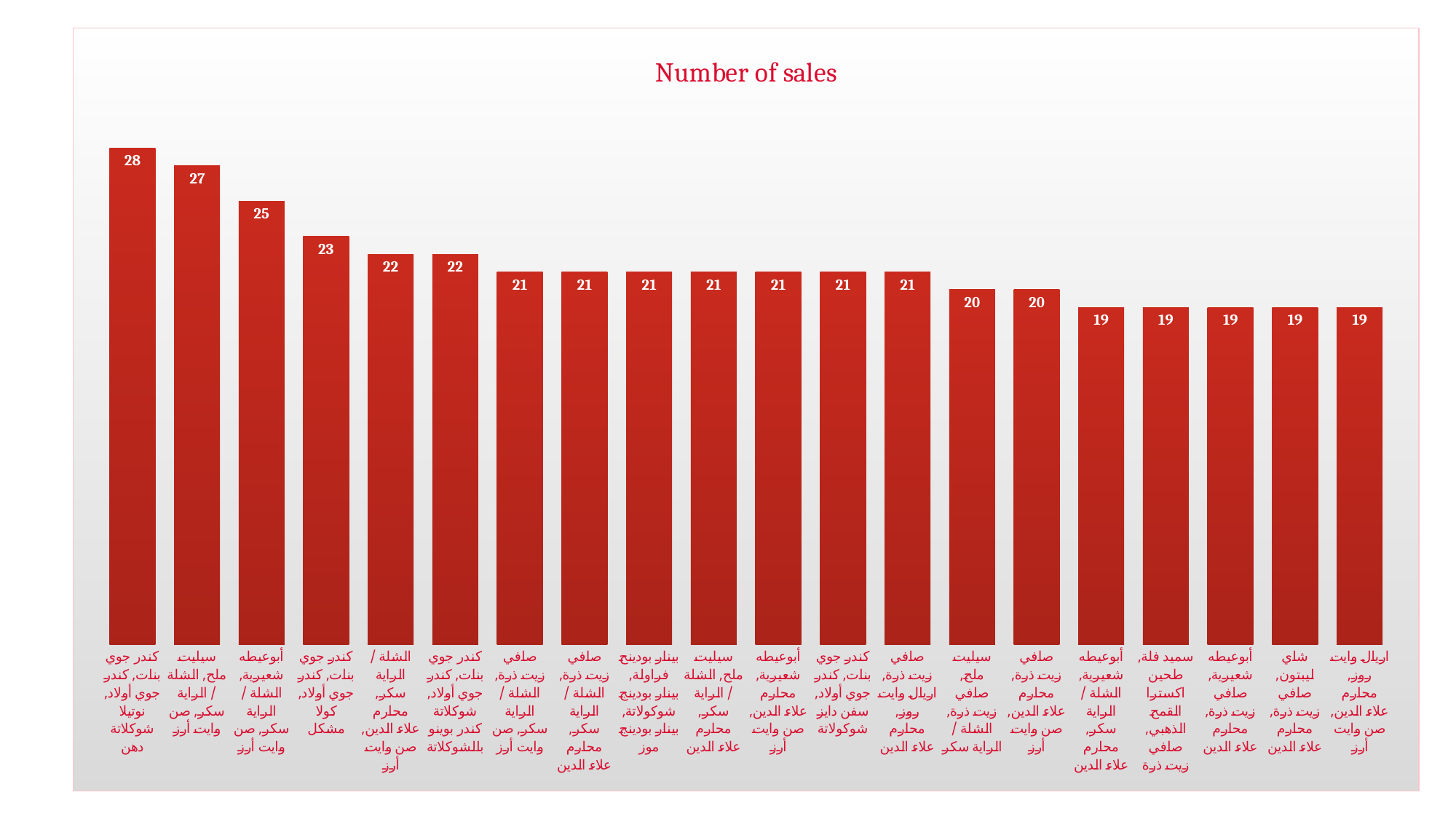
What is the value of the second bar from the left? 27 What is the difference between the highest value (28) and the lowest value (19) in the chart? 9 Do the values rise or fall from left to right across the chart? fall What is the highest value shown in the chart? 28 What is the value for the category 'سميد فلة, طحين اكسترا القمح الذهبي, صافي زيت ذرة'? 19 What is the lowest value shown in the chart? 19 How many bars are plotted in the chart? 20 Which is larger: the value of the third bar from the left or the value of the fourth bar from the left? the third bar (25) What is the value of the leftmost bar in the chart? 28 What is the title of the chart? Number of sales What kind of chart is shown on the slide? bar chart What is the value for the category 'كندر جوي بنات, كندر جوي أولاد, كولا مشكل'? 23